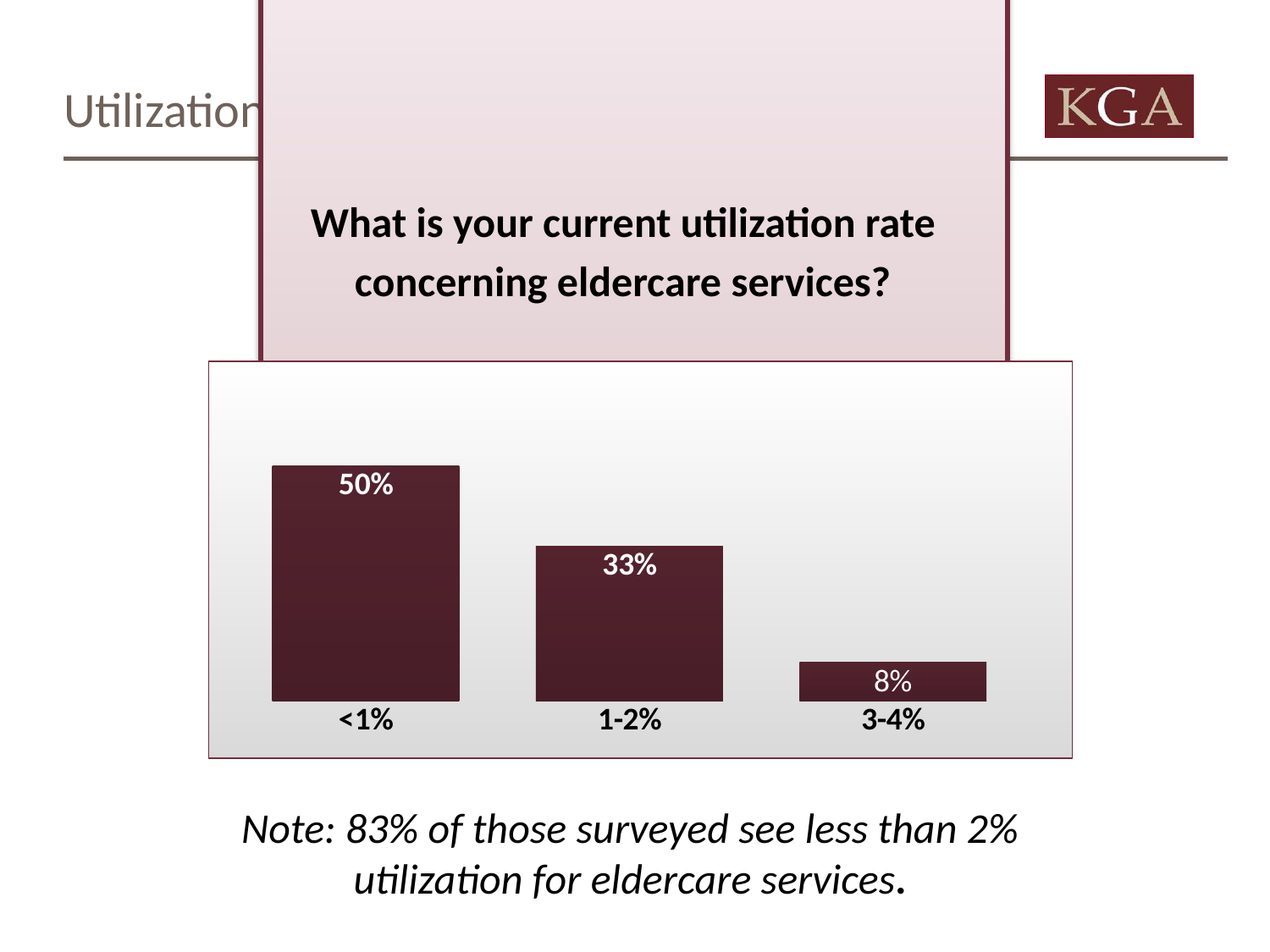
What is the value for the <1% category? 50% What is the difference between the values for 1-2% and 3-4%? 25% How many categories are shown in the chart? 3 Which category has the lowest value? 3-4% What kind of chart is shown on the slide? Bar chart Which is larger, the value for 1-2% or the value for 3-4%? 1-2% What is the difference between the values for <1% and 1-2%? 17% Which category has the highest value? <1% What question does the chart's title ask? What is your current utilization rate concerning eldercare services? What is the value for the 3-4% category? 8% Do the values rise or fall from left to right across the categories? Fall What is the value for the 1-2% category? 33%